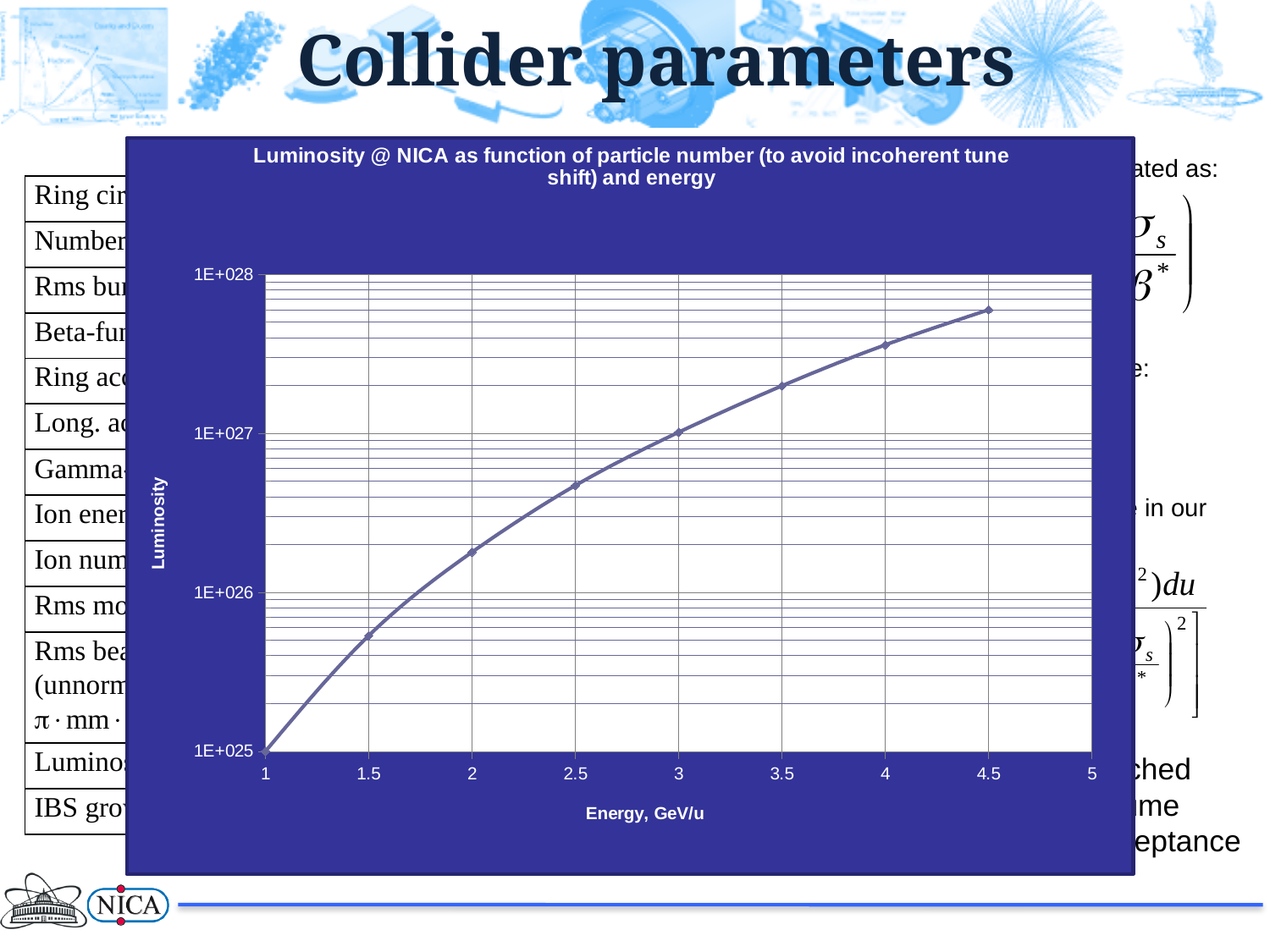
Does the luminosity rise or fall as energy increases along the x axis? rise What is the label of the x axis of the chart? Energy, GeV/u At which energy is the luminosity lowest? 1 At which energy is the luminosity highest? 4.5 Is the luminosity at 4.5 GeV/u greater or less than 1E+028? less What kind of chart is shown on the slide? line chart Is the luminosity at 3 GeV/u greater or less than 1E+026? greater Is the luminosity at 1.5 GeV/u greater or less than 1E+026? less How many data points are plotted on the chart? 8 What is the title of the chart? Luminosity @ NICA as function of particle number (to avoid incoherent tune shift) and energy Which is larger, the luminosity at 3 GeV/u or at 2 GeV/u? 3 GeV/u